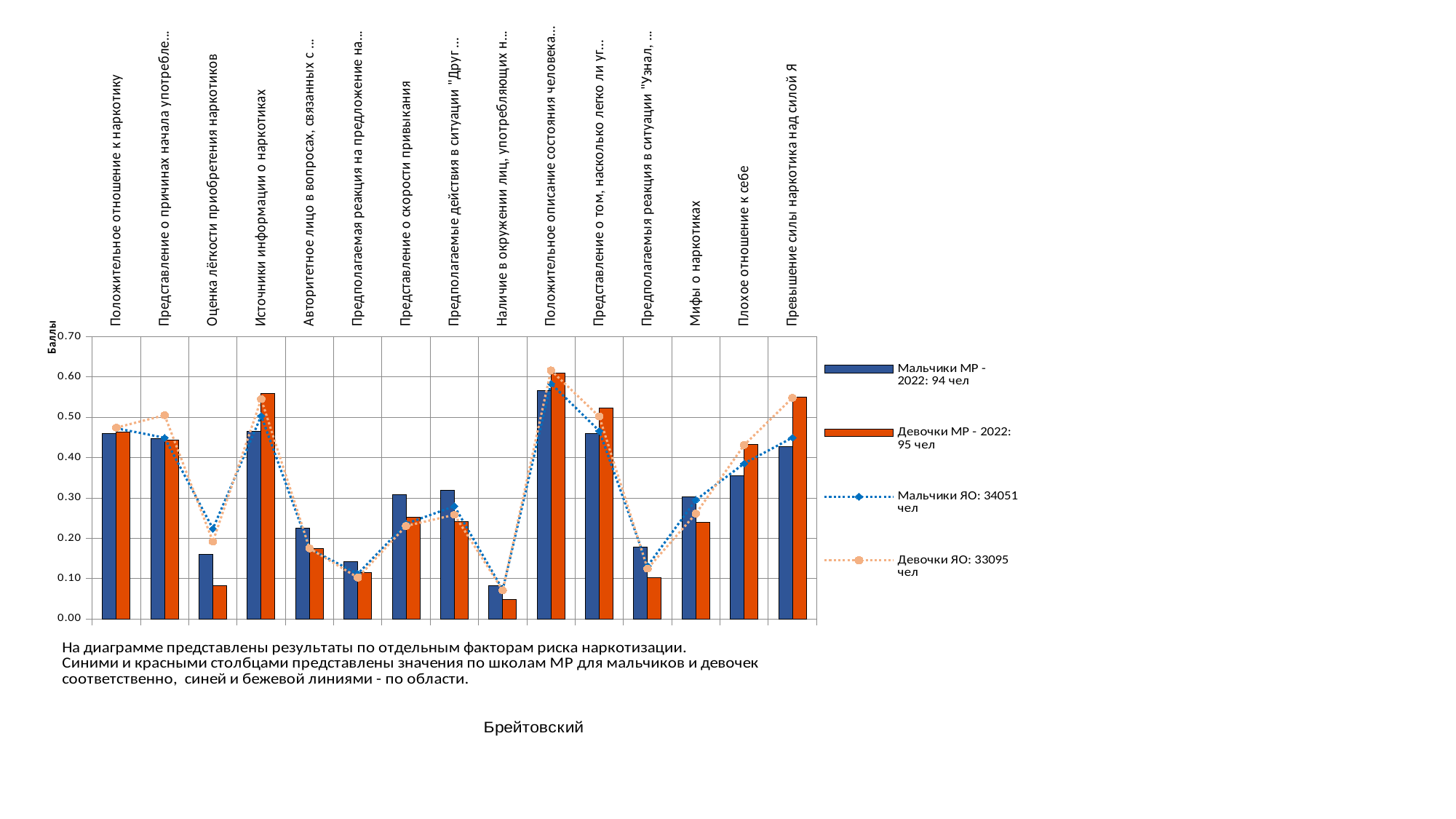
How many categories are shown along the x axis? 15 For "Оценка лёгкости приобретения наркотиков", which bar is taller: "Мальчики МР - 2022: 94 чел" or "Девочки МР - 2022: 95 чел"? Мальчики МР - 2022: 94 чел For "Представление о скорости привыкания", which bar is taller: "Мальчики МР - 2022: 94 чел" or "Девочки МР - 2022: 95 чел"? Мальчики МР - 2022: 94 чел Is the value of the "Девочки МР - 2022: 95 чел" bar for "Превышение силы наркотика над силой Я" greater or less than 0.50? greater Which legend entry is drawn as a dotted line with circle markers? Девочки ЯО: 33095 чел Is the value of the "Мальчики МР - 2022: 94 чел" bar for "Мифы о наркотиках" greater or less than 0.20? greater How many series does the legend list? 4 What is the title of the vertical axis? Баллы Is the value of the "Девочки МР - 2022: 95 чел" bar for "Плохое отношение к себе" greater or less than 0.40? greater What kind of chart is this? Combined bar and line chart For "Превышение силы наркотика над силой Я", which bar is taller: "Мальчики МР - 2022: 94 чел" or "Девочки МР - 2022: 95 чел"? Девочки МР - 2022: 95 чел